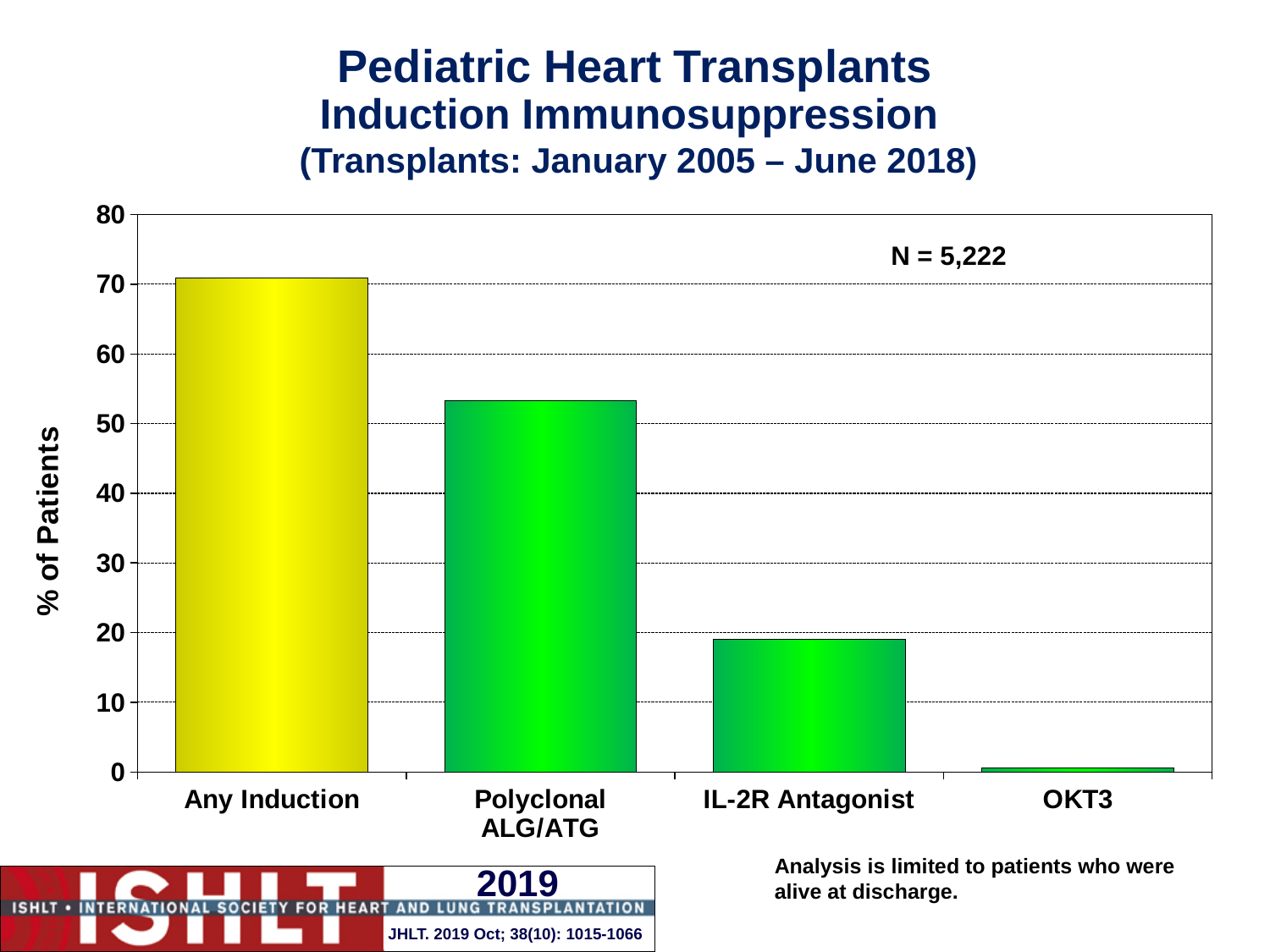
Is the value for Any Induction greater or less than 70? greater Do the bar values rise or fall from left to right along the x axis? fall What is the label of the y axis? % of Patients Is the value for OKT3 greater or less than 10? less Which is larger, the value for Polyclonal ALG/ATG or the value for IL-2R Antagonist? Polyclonal ALG/ATG Is the value for IL-2R Antagonist greater or less than 20? less Which category has the lowest percentage of patients? OKT3 What kind of chart is shown on the slide? bar chart What is the N value shown on the chart? N = 5,222 Which category has the highest percentage of patients? Any Induction How many categories are shown on the x axis of the chart? 4